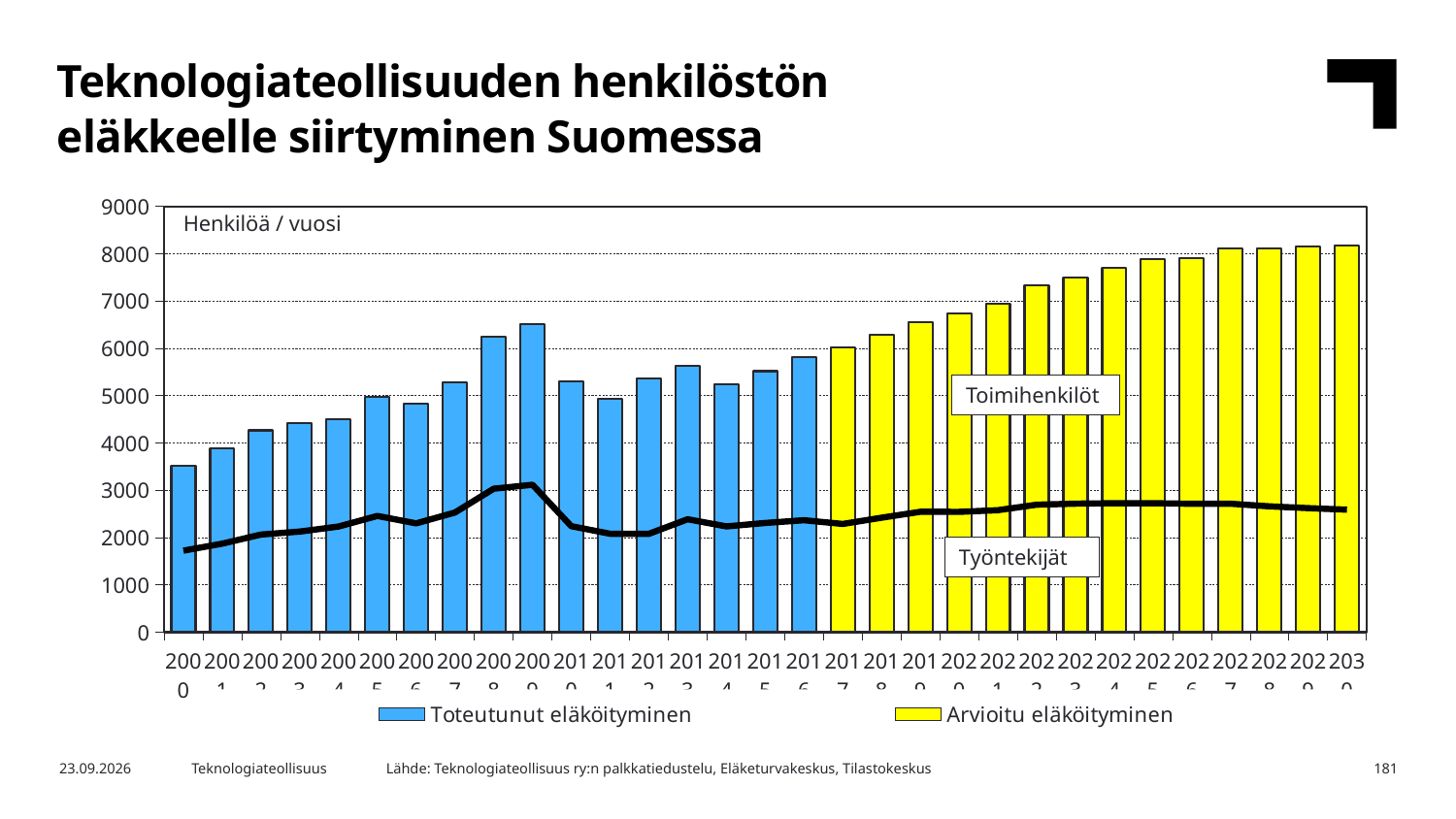
Is the bar for 2009 greater or less than 6000? greater Is the bar for 2030 greater or less than 8000? greater Which bar is taller, 2009 or 2010? 2009 How many years (bars) are plotted on the x axis? 31 Do the yellow (Arvioitu eläköityminen) bars rise or fall from 2017 to 2030? rise How many series does the legend list? 2 Is the bar for 2000 greater or less than 4000? less What unit label is shown at the top left of the plot area? Henkilöä / vuosi Which year has the lowest bar? 2000 Which legend entry corresponds to the blue bars? Toteutunut eläköityminen What kind of chart is shown on the slide? combination bar and line chart